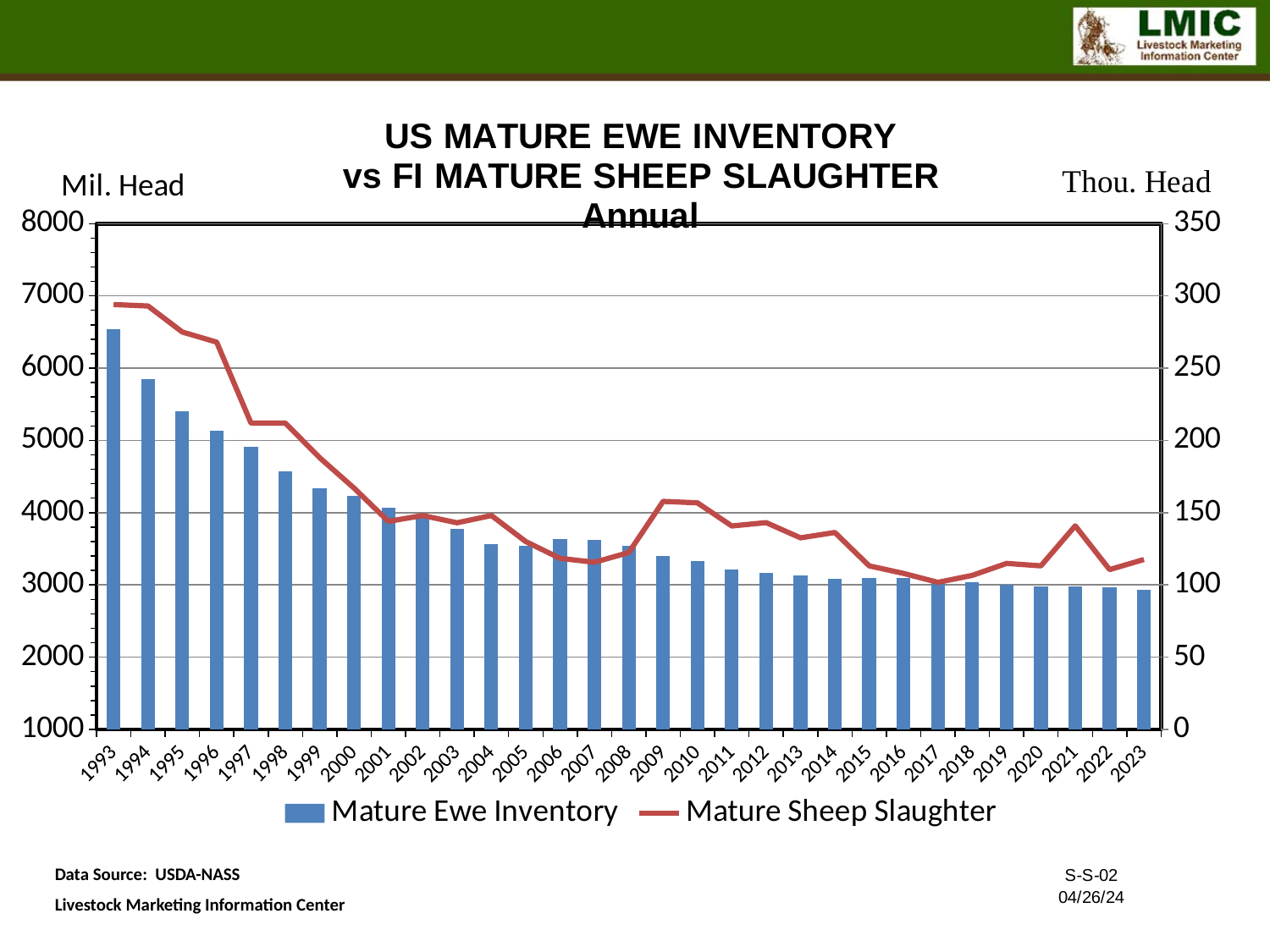
Is the Mature Sheep Slaughter value for 2017 greater or less than 150? less Is the Mature Ewe Inventory value for 1993 greater or less than 6000? greater How many years are shown along the x axis? 31 Is the Mature Sheep Slaughter value for 1993 greater or less than 250? greater What kind of chart is shown on the slide? A combination bar and line chart How many series does the legend list? 2 Which year has the lowest Mature Ewe Inventory bar? 2023 Which year has the highest Mature Ewe Inventory bar? 1993 Which year has the highest Mature Sheep Slaughter value? 1993 Does the Mature Ewe Inventory generally rise or fall from 1993 to 2023? fall Which series is plotted as a red line? Mature Sheep Slaughter